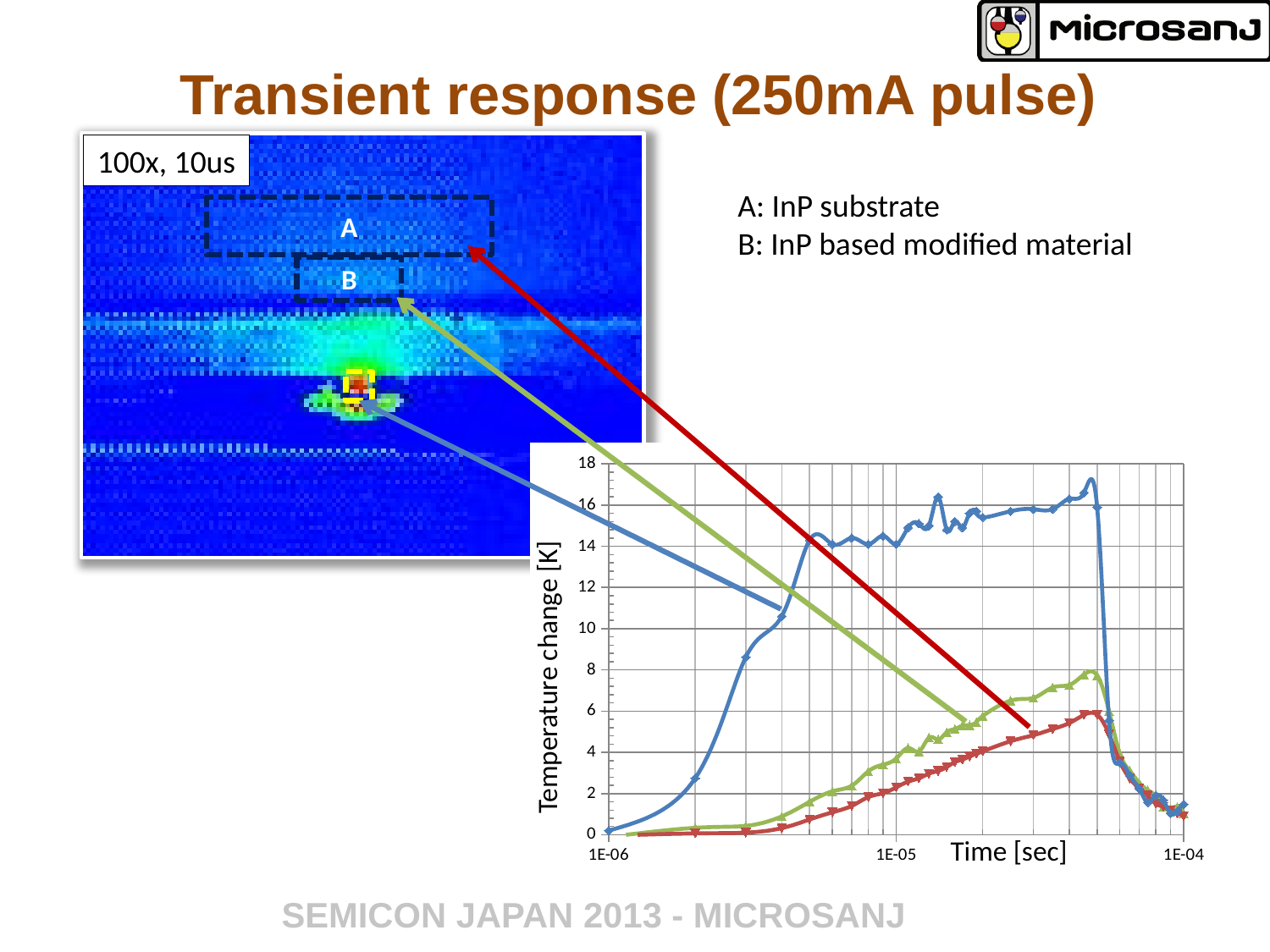
What is the label of the horizontal axis of the chart? Time [sec] Which line is higher at 1E-05 seconds, the blue line or the red line? the blue line Which line has the lowest peak temperature change on the chart? the red line What kind of chart is shown on the slide? line chart Which line reaches the highest temperature change on the chart? the blue line Is the value of the blue line at 1E-05 seconds greater or less than 12? greater After their peaks, do the values of all three lines rise or fall as time increases toward 1E-04? fall Is the peak value of the red line greater or less than 8? less Is the peak value of the blue line greater or less than 16? greater How many lines are plotted on the chart? 3 What is the label of the vertical axis of the chart? Temperature change [K]